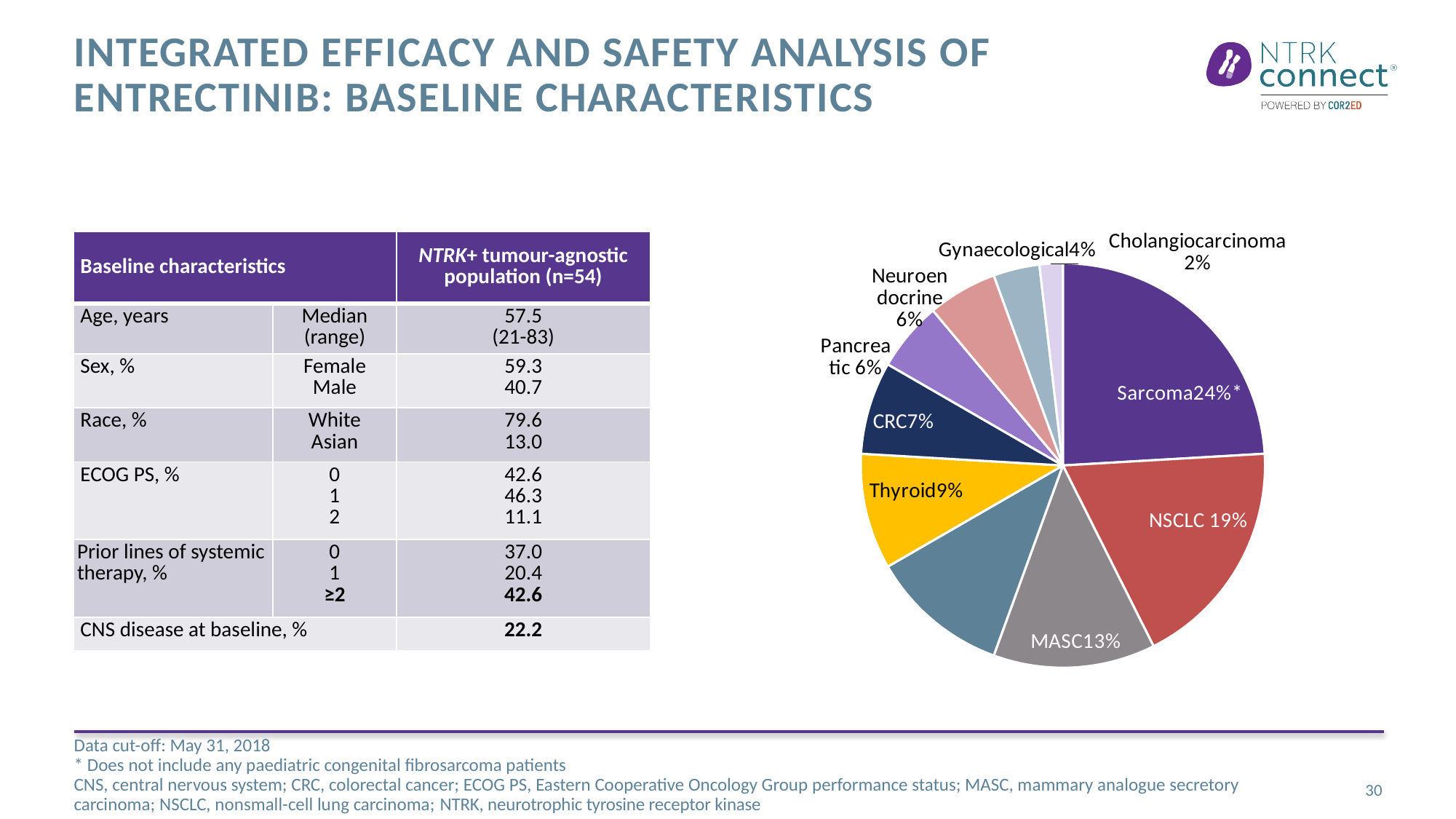
In the pie chart, what share is labelled for MASC? 13% What type of chart is shown on the right of the slide? Pie chart In the pie chart, what share is labelled for CRC? 7% In the pie chart, what share is labelled for NSCLC? 19% In the pie chart, what share is labelled for Sarcoma? 24% In the pie chart, what share is labelled for Cholangiocarcinoma? 2% In the pie chart, which slice is larger: Thyroid or CRC? Thyroid In the pie chart, what share is labelled for Thyroid? 9% In the pie chart, how many percentage points larger is the Sarcoma share than the NSCLC share? 5 percentage points In the pie chart, which slice is larger: MASC or Gynaecological? MASC Which labelled tumour type has the smallest slice in the pie chart? Cholangiocarcinoma Which labelled tumour type has the largest slice in the pie chart? Sarcoma